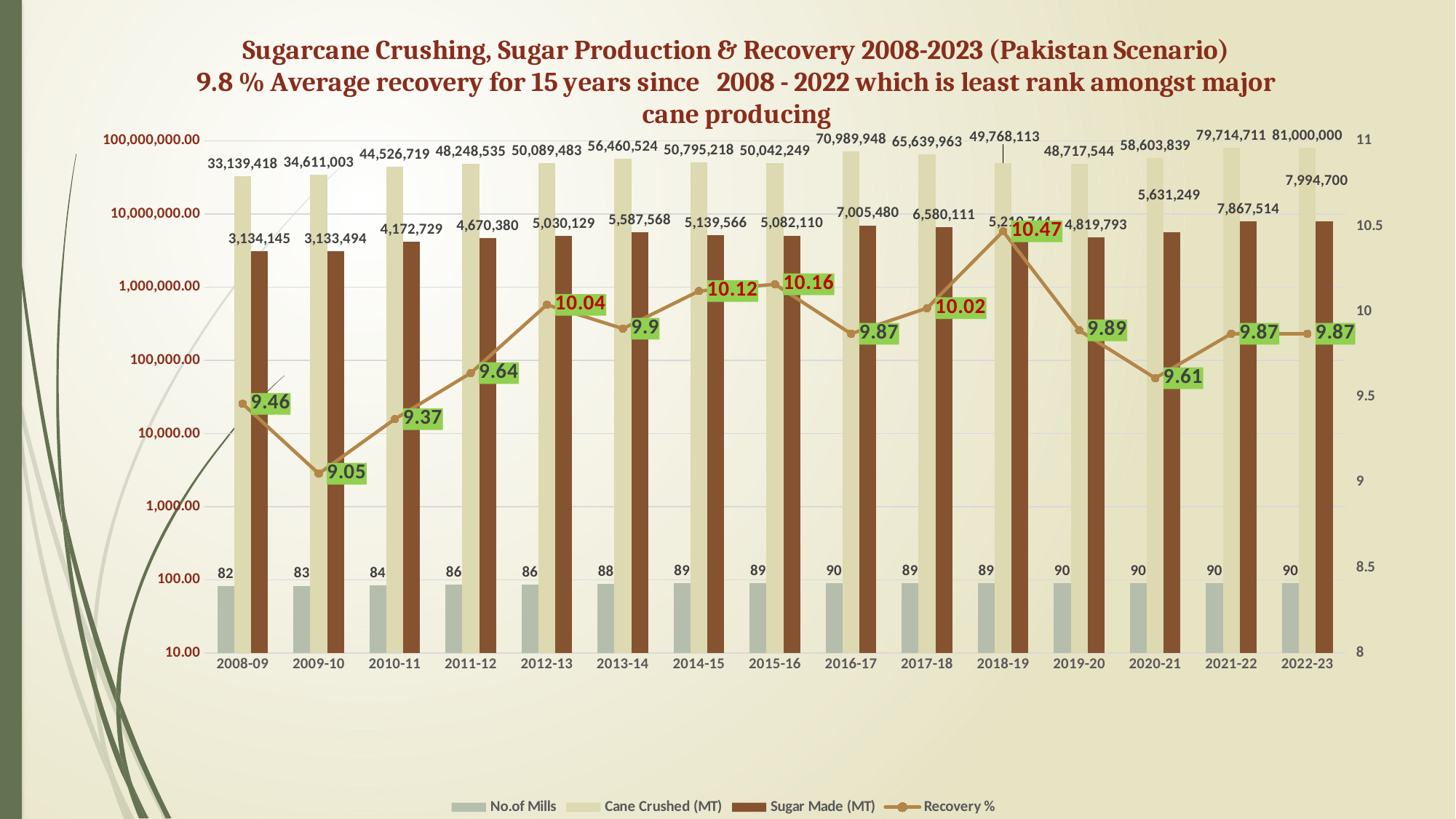
Did the Recovery % rise or fall from 2009-10 to 2012-13? rise By how many did the number of mills increase from 2008-09 to 2022-23? 8 How many years (categories) are shown on the x axis? 15 What was the Recovery % for 2009-10? 9.05 How many mills (No.of Mills) were there in 2011-12? 86 What was the Sugar Made (MT) value for 2013-14? 5,587,568 Which year had a higher Cane Crushed (MT) value, 2017-18 or 2019-20? 2017-18 Which year had the highest Recovery %? 2018-19 How many series does the legend list? 4 Which year had the lowest Cane Crushed (MT) value? 2008-09 What is the difference in Sugar Made (MT) between 2022-23 and 2021-22? 127,186 What was the Cane Crushed (MT) value for 2016-17? 70,989,948